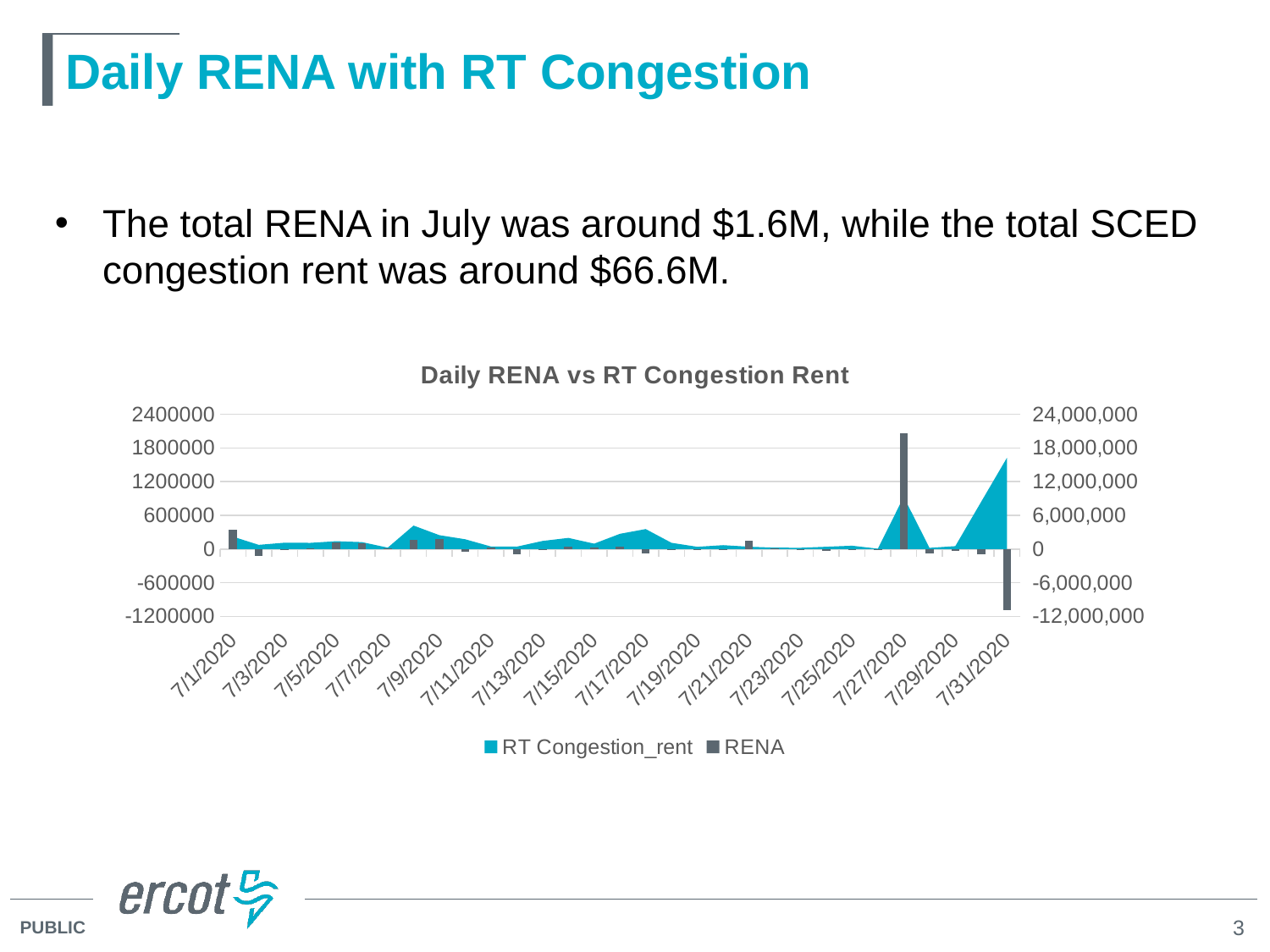
How many series does the chart legend list? 2 On which date does the RT Congestion_rent area reach its highest peak? 7/31/2020 On which date does the RENA bar reach its highest value? 7/27/2020 How many date labels are shown along the x axis of the chart? 16 On the left axis, is the RENA bar for 7/27/2020 greater or less than 1200000? greater Which series is drawn in teal/blue in the chart? RT Congestion_rent Which date has the larger RT Congestion_rent value, 7/27/2020 or 7/31/2020? 7/31/2020 What kind of chart is shown on the slide? A combination chart with an area series and a bar series What is the title of the chart on the slide? Daily RENA vs RT Congestion Rent On the left axis, is the RENA bar for 7/31/2020 greater or less than -600000? less On which date does the RENA bar reach its lowest (most negative) value? 7/31/2020 Which date has the larger RENA bar, 7/27/2020 or 7/31/2020? 7/27/2020